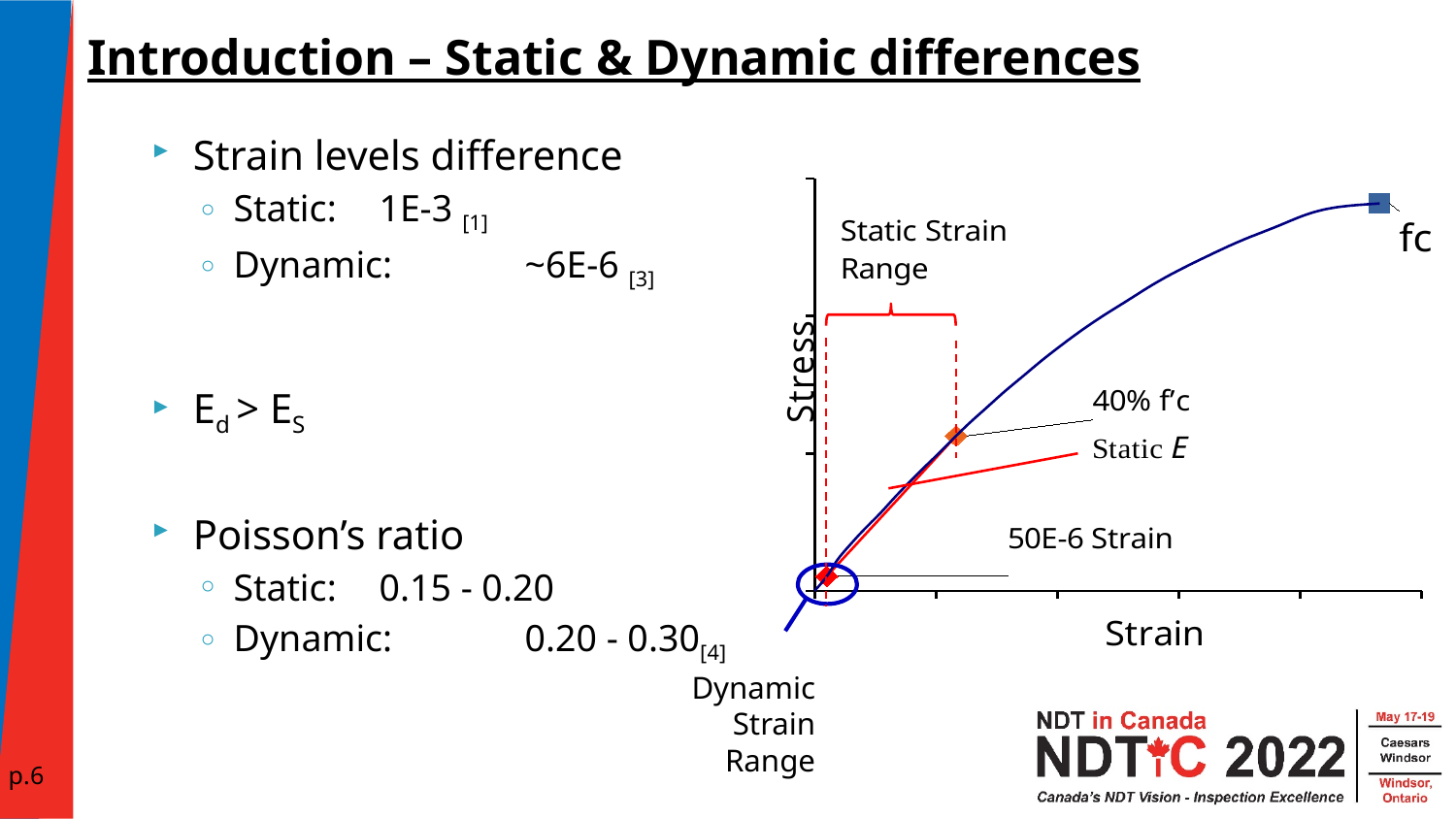
What stress level is indicated at the orange marker on the curve? 40% f'c What label marks the peak of the stress-strain curve? fc Which labelled strain range lies closer to the origin, the Static Strain Range or the Dynamic Strain Range? Dynamic Strain Range What is the label on the vertical axis of the chart? Stress Does the stress curve rise or fall as strain increases from the origin up to the peak? rise How many strain ranges are labelled on the chart? 2 What is the red straight line on the chart labelled? Static E What is the label on the horizontal axis of the chart? Strain What kind of chart is shown on the slide? line chart What strain value is annotated near the origin of the curve? 50E-6 Strain